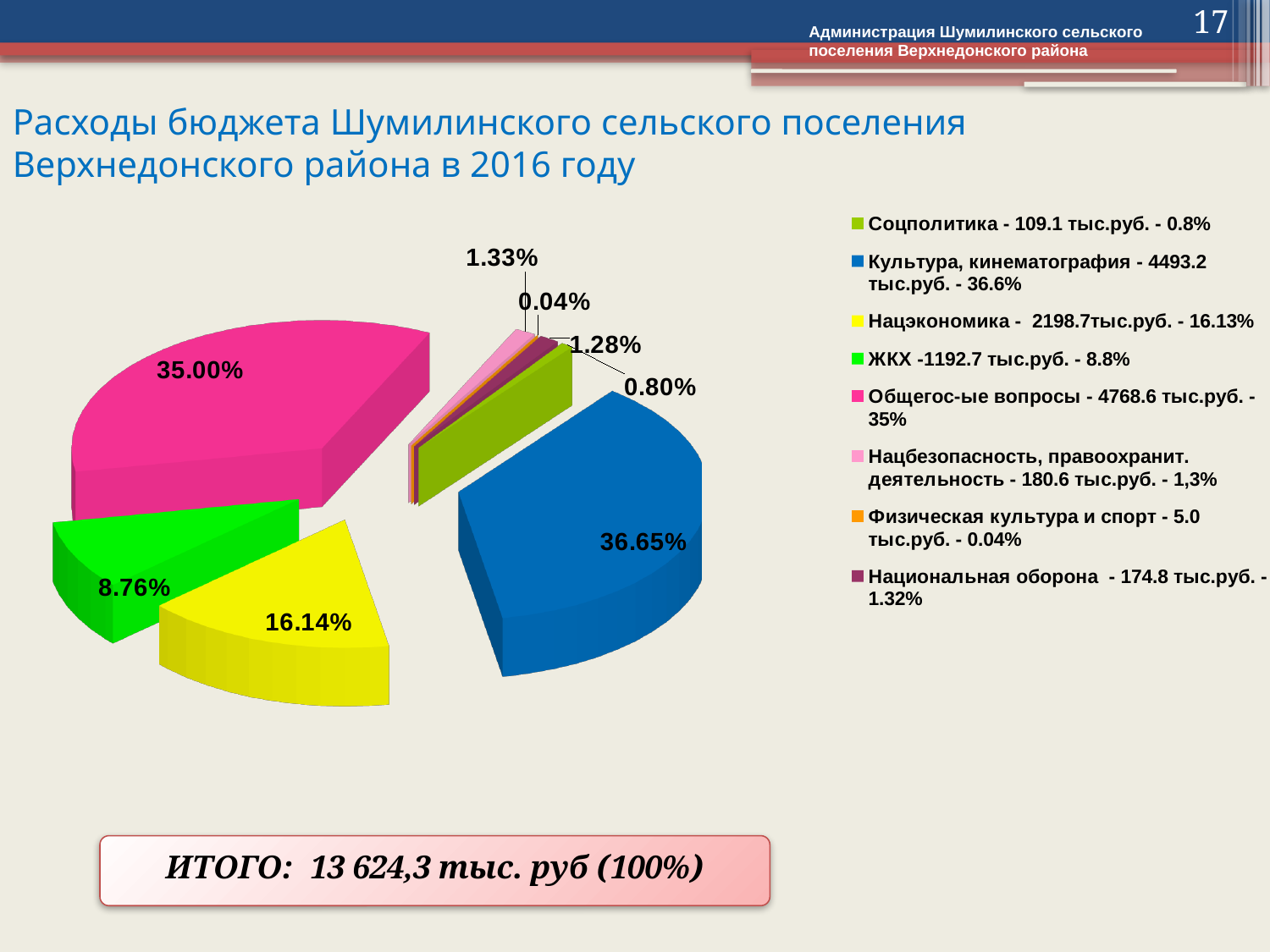
Which category has the smallest share of the pie? Физическая культура и спорт What percentage is shown on the data label for the yellow slice (Нацэкономика)? 16.14% What percentage is shown on the data label for the blue slice (Культура, кинематография)? 36.65% What is the difference between the data labels of the blue slice (36.65%) and the pink slice (35.00%)? 1.65% Which slice is larger: ЖКХ or Нацэкономика? Нацэкономика How many slices does the pie chart have? 8 What total amount is shown in the ИТОГО box at the bottom of the slide? 13 624,3 тыс. руб (100%) According to the legend, what is the amount in тыс.руб. for Общегос-ые вопросы? 4768.6 тыс.руб. What kind of chart is shown on the slide? Pie chart What percentage is shown on the data label for the green slice (ЖКХ)? 8.76% Which category has the largest share of the pie? Культура, кинематография What percentage is shown on the data label for the pink slice (Общегос-ые вопросы)? 35.00%